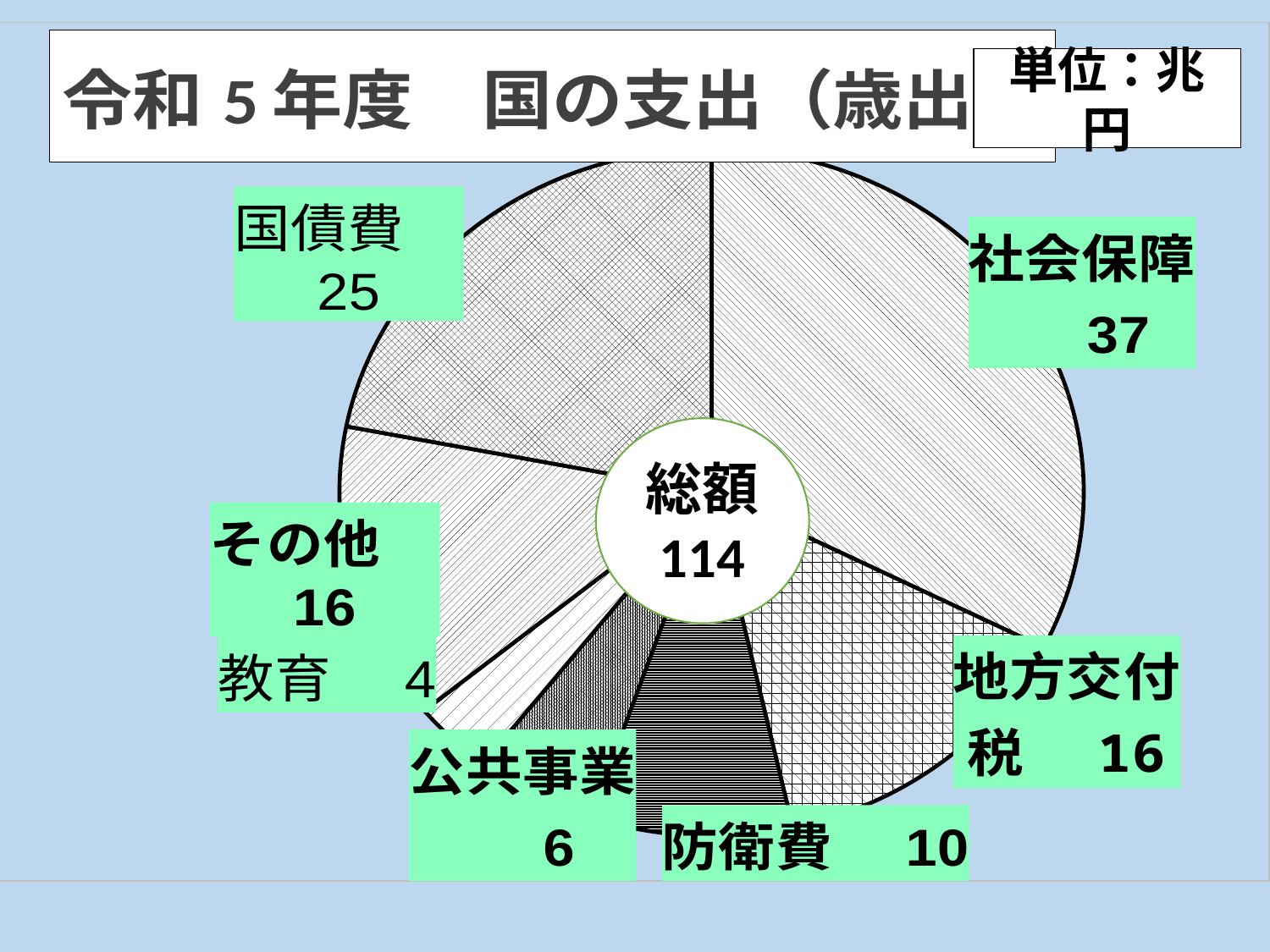
How many categories are shown in the pie chart? 7 Which is larger, 防衛費 or 公共事業? 防衛費 What is the value for 国債費? 25 What is the total (総額) shown in the centre of the pie chart? 114 What is the value for 教育? 4 What unit is stated for the values on the slide? 兆円 Which category has the smallest value in the pie chart? 教育 What is the difference between 社会保障 and 国債費? 12 What kind of chart is shown on the slide? pie chart What is the value for 社会保障? 37 What is the value for 防衛費? 10 Which category has the largest value in the pie chart? 社会保障